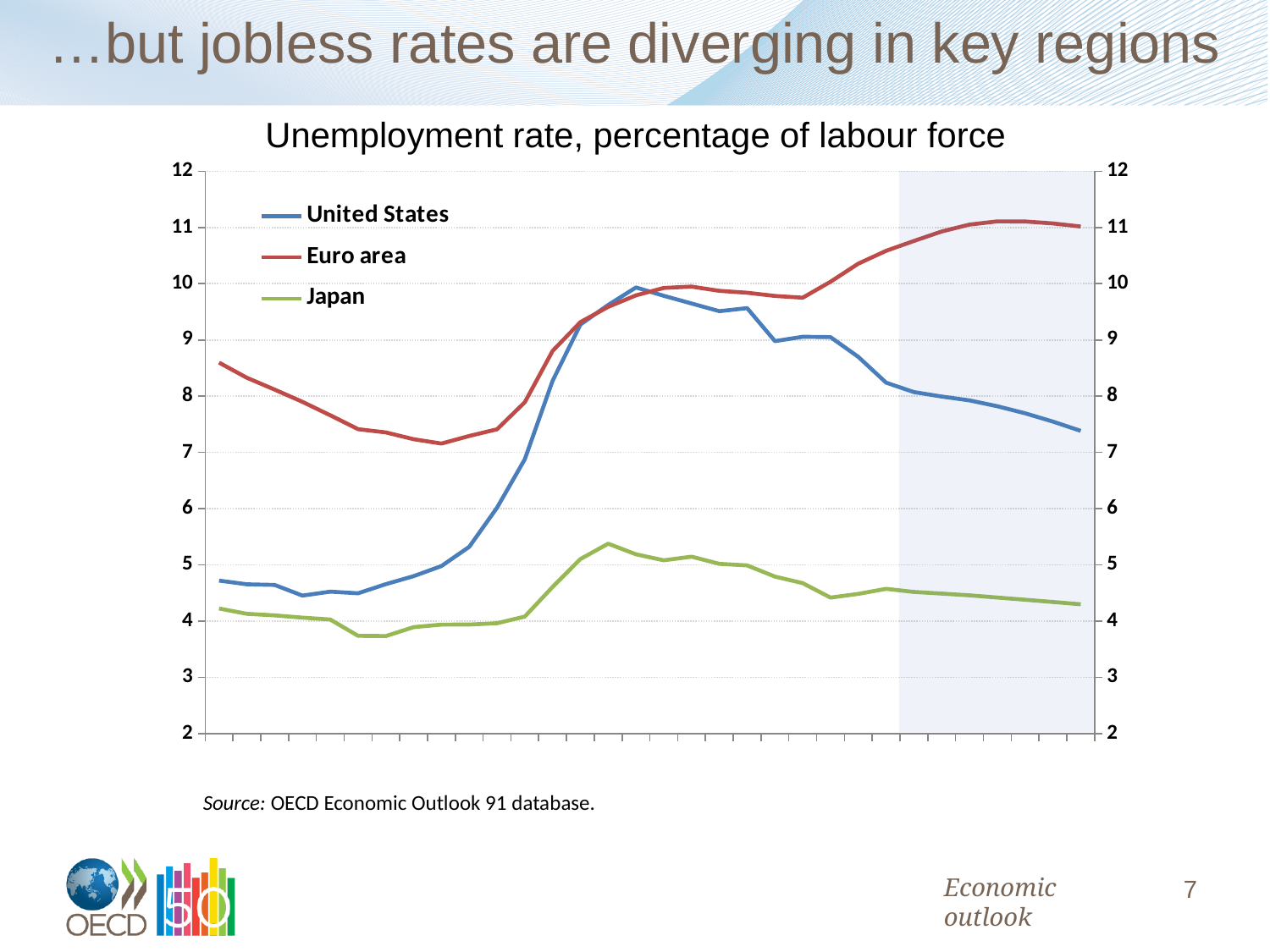
Is the Euro area value at the right-hand end of the chart greater or less than 10? greater Is the United States value at the left-hand start of the chart greater or less than 5? less How many series does the legend list? 3 Is the Japan value at the right-hand end of the chart greater or less than 5? less Which series reaches the highest value anywhere on the chart? Euro area Which colour is used for the Euro area line? red At the right-hand end of the chart, which is larger: the United States value or the Euro area value? Euro area Which series has the lowest value at the right-hand end of the chart? Japan Does the United States line end higher or lower than it starts? higher What is the title of the chart? Unemployment rate, percentage of labour force What kind of chart is shown on the slide? line chart Which series has the highest value at the right-hand end of the chart? Euro area